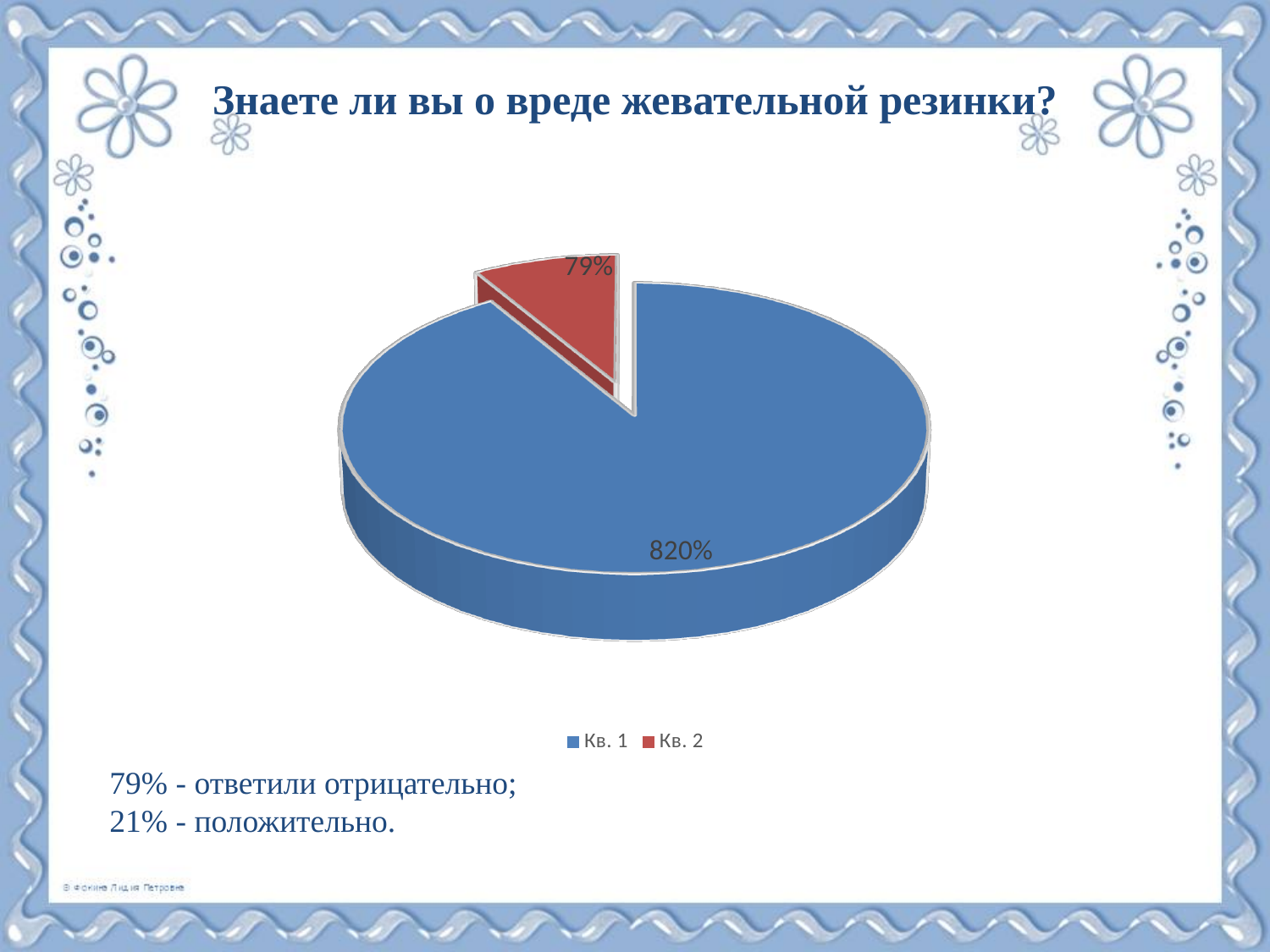
How many slices does the pie chart have? 2 How many entries does the legend of the pie chart list? 2 What kind of chart is shown on the slide? pie chart What data label is printed on the Кв. 1 slice of the pie chart? 820% What data label is printed on the Кв. 2 slice of the pie chart? 79% Which slice of the pie chart is the largest? Кв. 1 Which slice of the pie chart is the smallest? Кв. 2 Which slice is larger in the pie chart, Кв. 1 or Кв. 2? Кв. 1 What colour is the Кв. 2 slice in the pie chart? red What is the title of the slide above the pie chart? Знаете ли вы о вреде жевательной резинки?